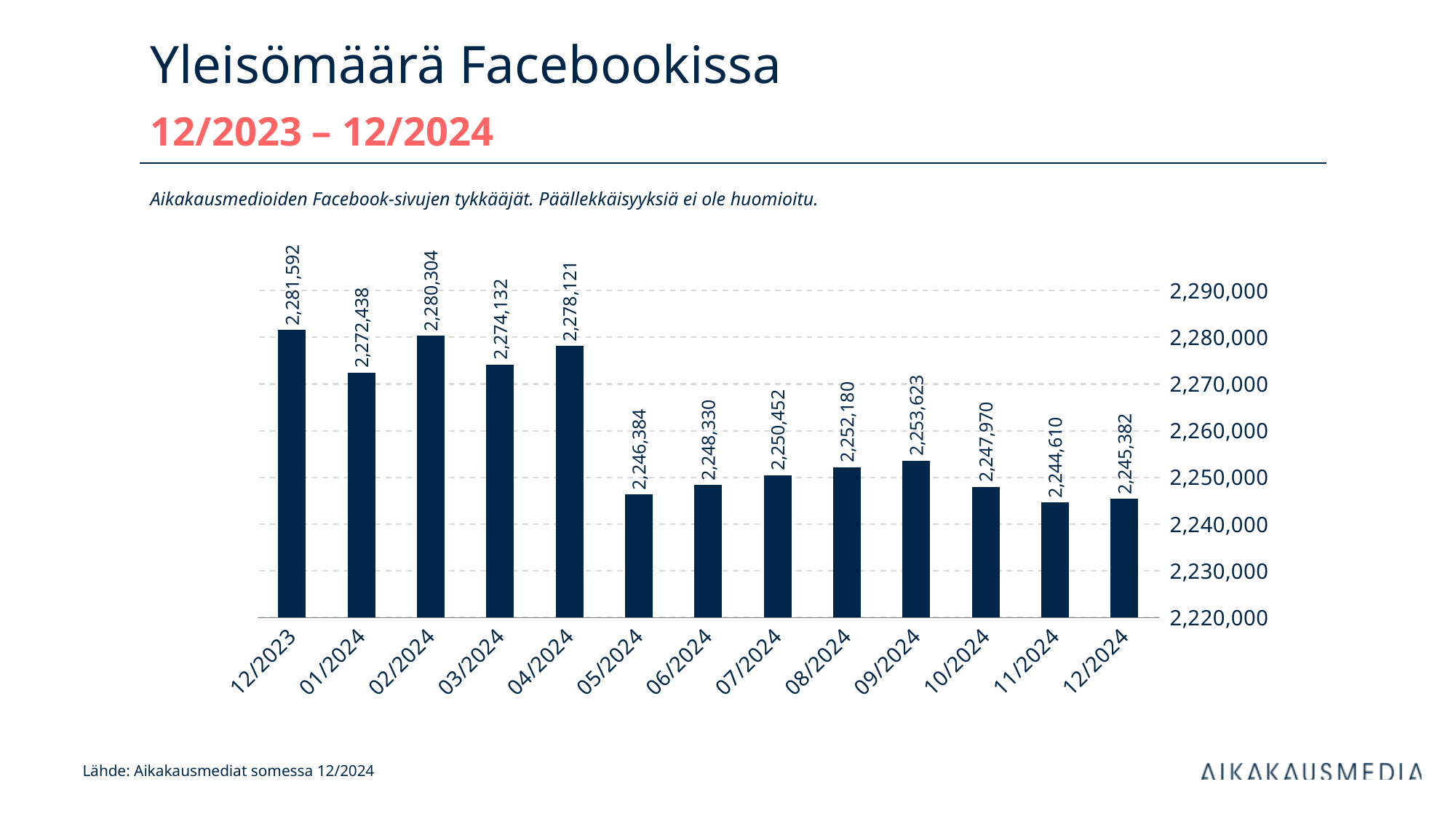
What is the value for 05/2024? 2,246,384 What kind of chart is shown on the slide? bar chart What is the difference between the values for 09/2024 and 05/2024? 7,239 Which is larger, the value for 02/2024 or the value for 04/2024? 02/2024 What is the value for 12/2023? 2,281,592 Which month has the lowest value? 11/2024 Do the values generally rise or fall from 12/2023 to 12/2024? fall What is the value for 12/2024? 2,245,382 How many months are shown on the x axis? 13 Which month has the highest value? 12/2023 Is the value for 05/2024 greater or less than 2,250,000? less What is the difference between the values for 12/2023 and 12/2024? 36,210